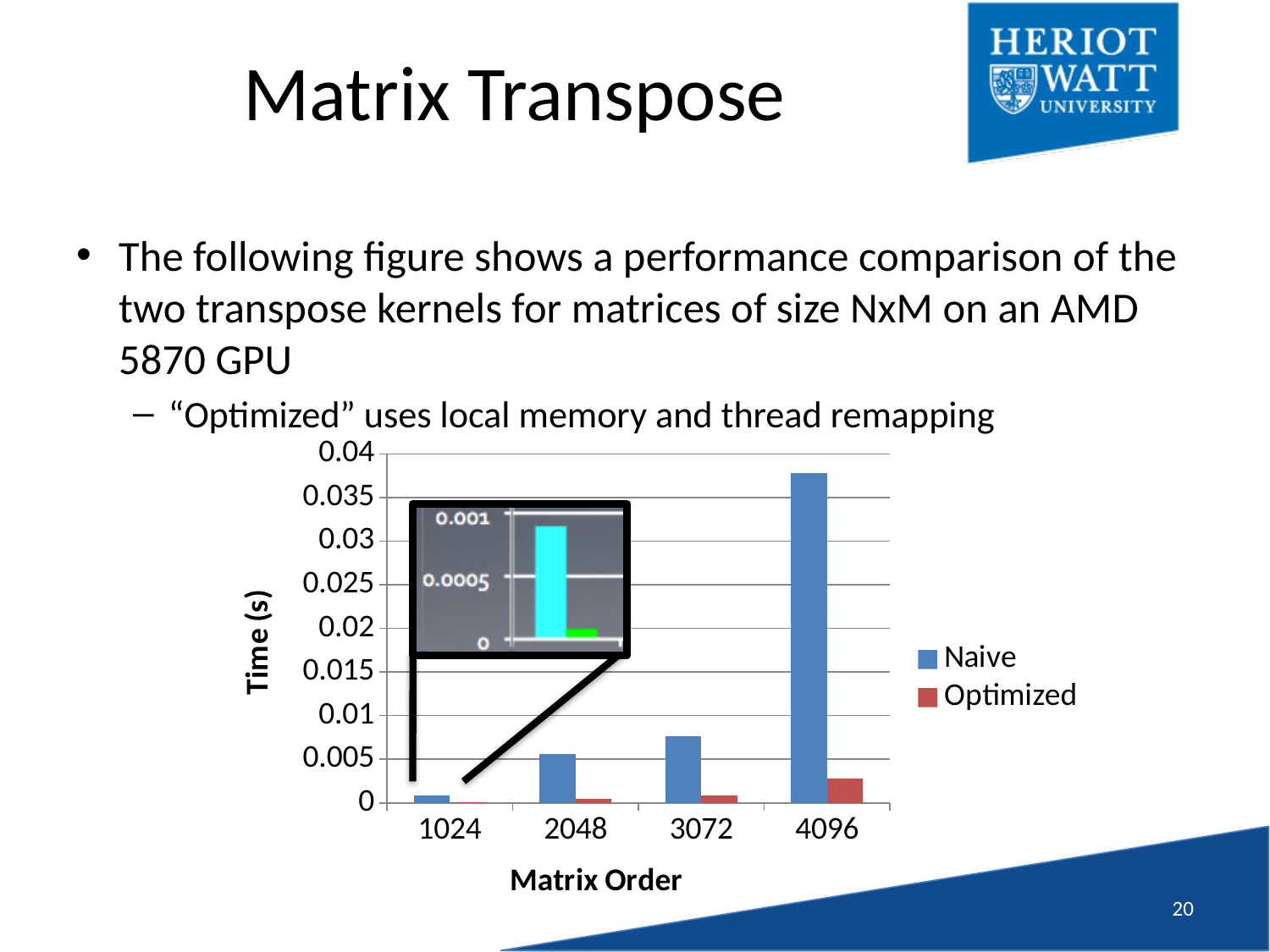
Which colour represents the Optimized series in the legend? red What kind of chart is shown on the slide? bar chart Does the Naive time rise or fall as the matrix order increases from 1024 to 4096? rise Is the Naive time for matrix order 3072 greater or less than 0.01? less Is the Optimized time for matrix order 4096 greater or less than 0.005? less For which matrix order is the Naive time highest? 4096 At matrix order 4096, which series has the larger time, Naive or Optimized? Naive Is the Naive time for matrix order 4096 greater or less than 0.035? greater How many matrix order categories are shown on the x axis? 4 What is the label of the y axis? Time (s) For which matrix order is the Naive time lowest? 1024 How many series does the legend list? 2